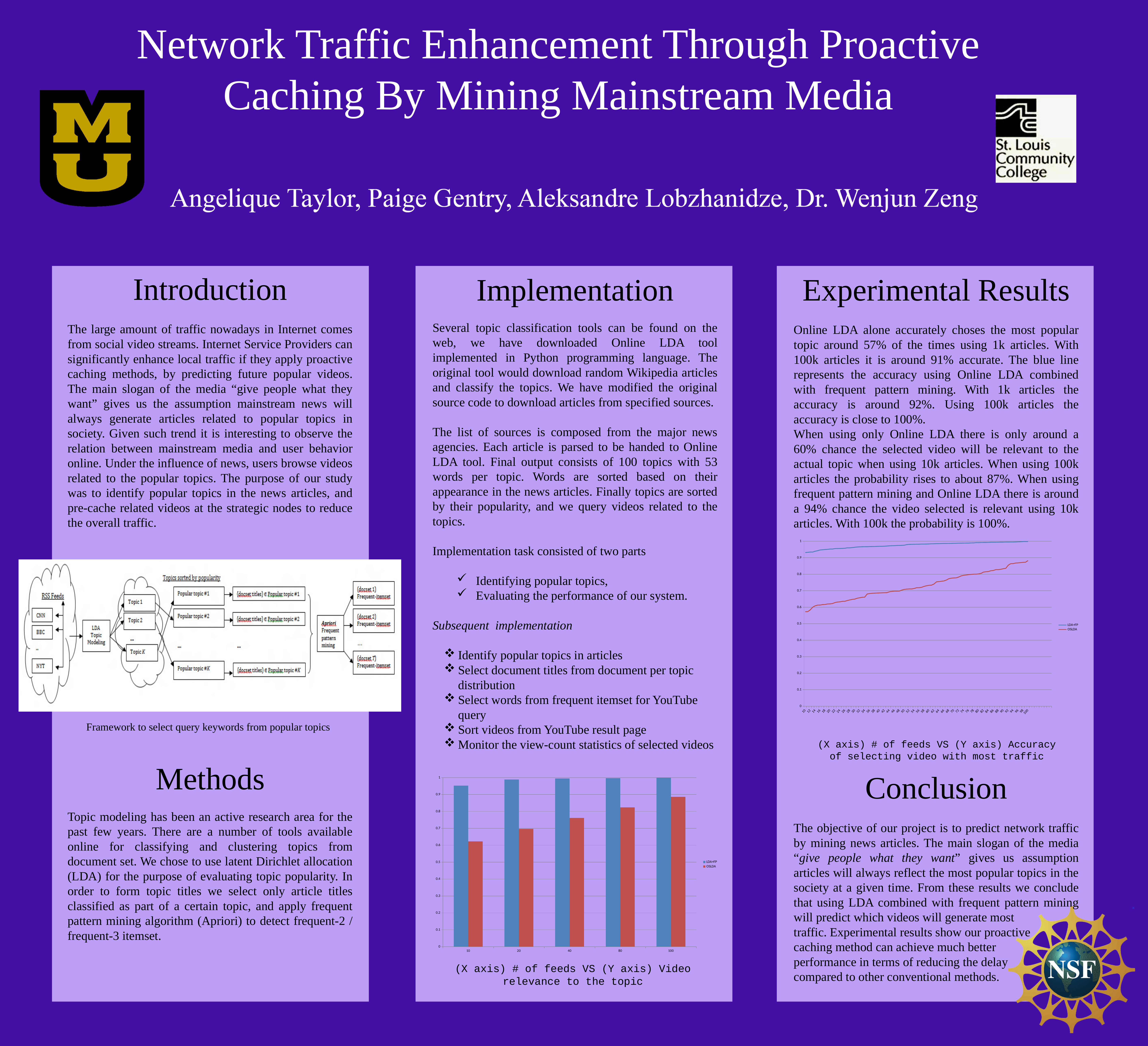
In the bar chart in the Implementation column, is the OSLDA value at 10 greater or less than 0.5? greater In the line chart in the Experimental Results column, does the OSLDA line rise or fall along the x axis? rise In the bar chart in the Implementation column, at which x-axis category is the OSLDA bar lowest? 10 In the bar chart in the Implementation column, how many categories are shown on the x axis? 5 In the bar chart in the Implementation column, how many series does the legend list? 2 In the bar chart in the Implementation column, is the LDA+FP value at 10 greater or less than 0.9? greater In the bar chart in the Implementation column, do the OSLDA values rise or fall as the number of feeds increases along the x axis? rise In the bar chart in the Implementation column, which series is shown in blue? LDA+FP What kind of chart is shown in the Experimental Results column? line chart What kind of chart is shown in the Implementation column? bar chart In the bar chart in the Implementation column, is the OSLDA value at 10 greater or less than 0.7? less In the bar chart in the Implementation column, which series has the larger value at 10, LDA+FP or OSLDA? LDA+FP